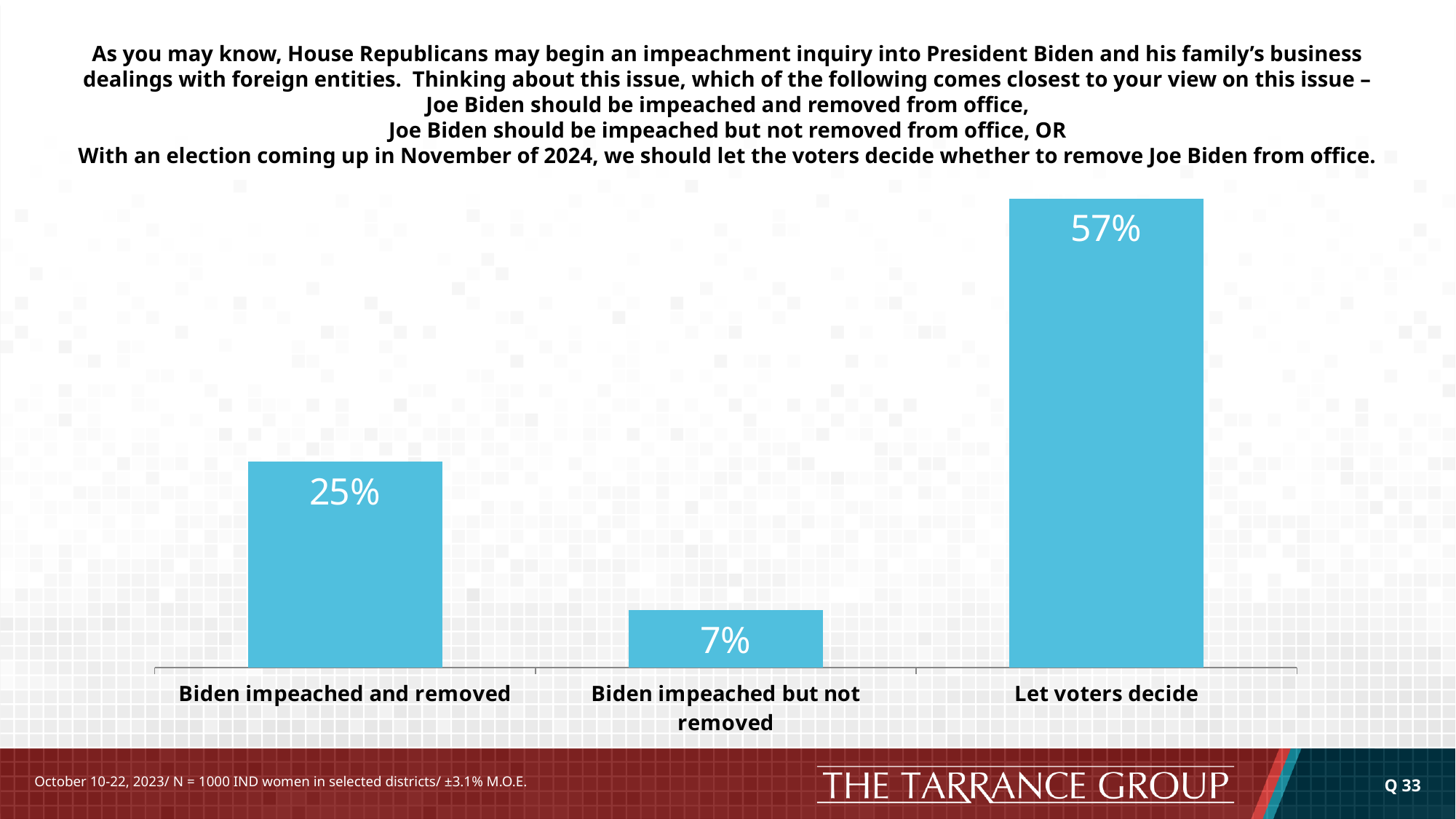
What percentage of respondents chose "Let voters decide"? 57% What is the combined percentage of the two impeachment options ("Biden impeached and removed" plus "Biden impeached but not removed")? 32% What is the difference in percentage points between "Biden impeached and removed" and "Biden impeached but not removed"? 18 What percentage of respondents chose "Biden impeached and removed"? 25% What is the difference in percentage points between "Let voters decide" and "Biden impeached and removed"? 32 Which response option has the lowest percentage? Biden impeached but not removed Which response option has the highest percentage? Let voters decide What type of chart is shown on the slide? Bar chart What colour are the bars in the chart? Light blue How many response categories are shown in the chart? 3 What percentage of respondents chose "Biden impeached but not removed"? 7% Which is larger: the value for "Biden impeached and removed" or the value for "Biden impeached but not removed"? Biden impeached and removed